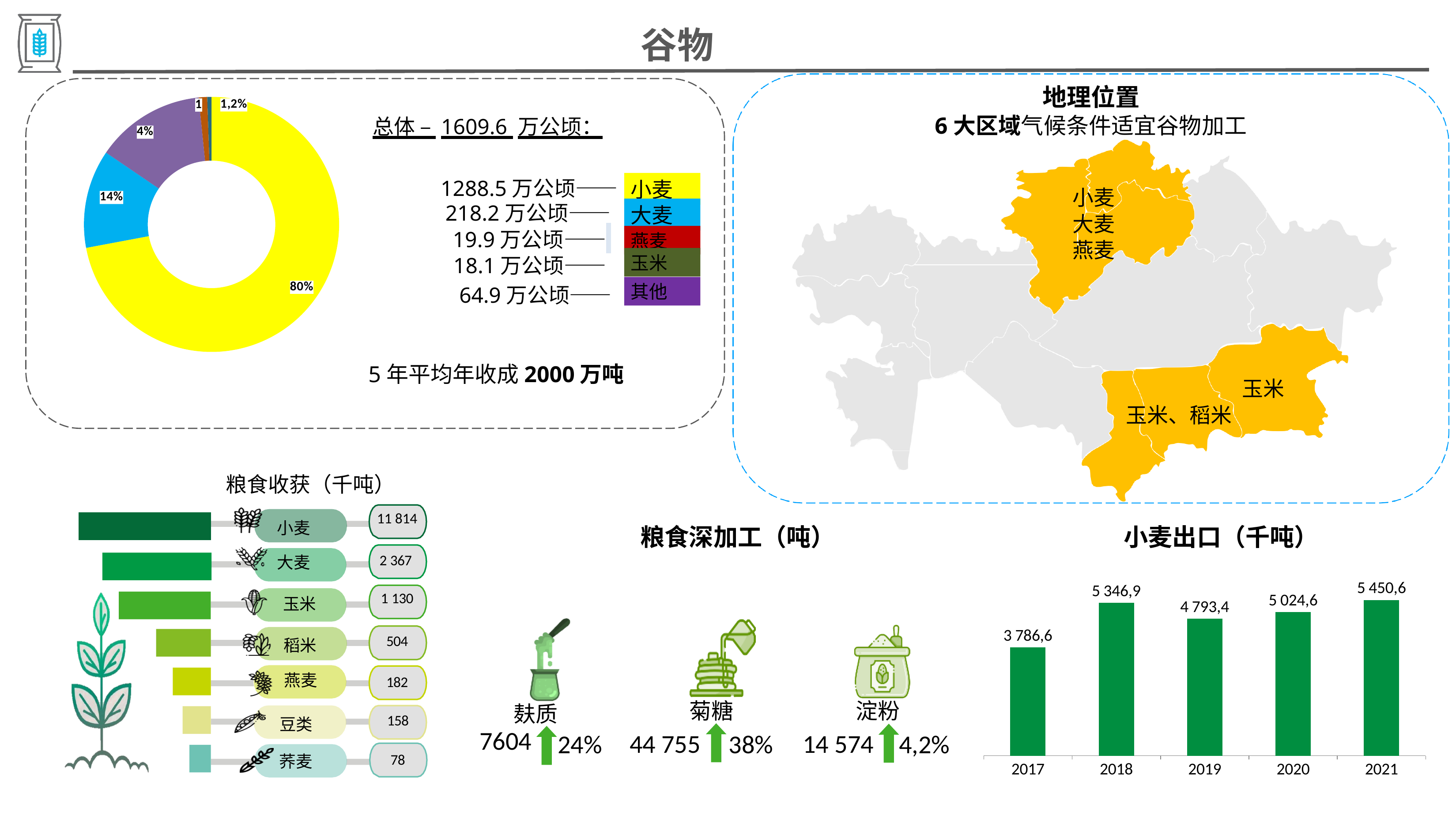
In the wheat export chart (小麦出口（千吨）), what is the value for 2017? 3 786,6 In the grain harvest chart (粮食收获（千吨）), which category has the lowest value? 荞麦 In the wheat export chart (小麦出口（千吨）), which year has the highest value? 2021 In the grain harvest chart (粮食收获（千吨）), what is the difference between the values for 大麦 and 玉米? 1 237 In the grain harvest chart (粮食收获（千吨）), how many categories are shown? 7 In the wheat export chart (小麦出口（千吨）), what is the value for 2021? 5 450,6 In the donut chart at the top left, what share does 小麦 have? 80% In the grain harvest chart (粮食收获（千吨）), what is the value for 小麦? 11 814 In the wheat export chart (小麦出口（千吨）), how many years are shown? 5 In the wheat export chart (小麦出口（千吨）), which is larger, the value for 2018 or the value for 2019? 2018 In the grain harvest chart (粮食收获（千吨）), what is the value for 稻米? 504 In the wheat export chart (小麦出口（千吨）), which year has the lowest value? 2017